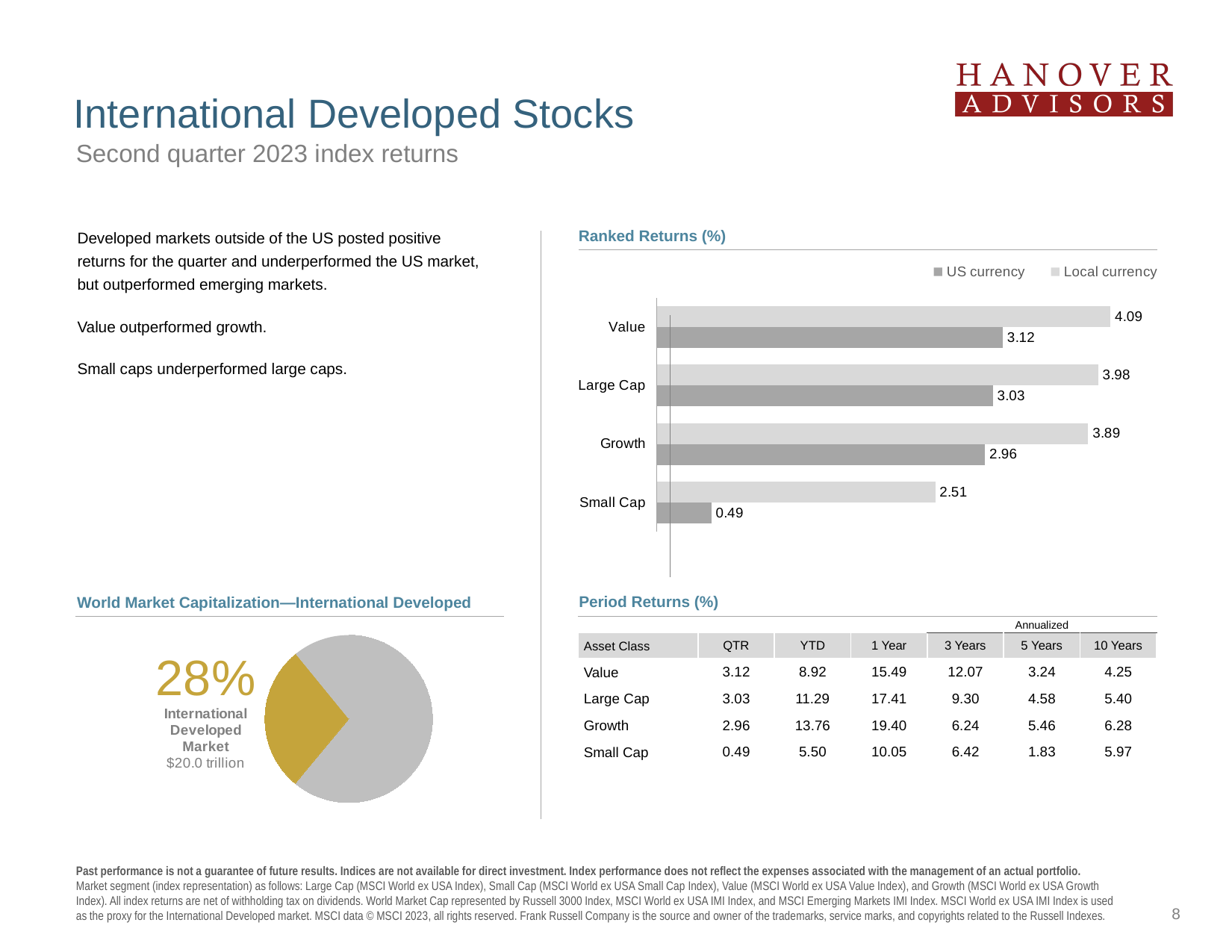
In the Ranked Returns (%) chart, which is larger for Large Cap: the US currency value or the Local currency value? Local currency In the Ranked Returns (%) chart, what is the difference between the Local currency and US currency values for Small Cap? 2.02 In the Ranked Returns (%) chart, which category has the highest Local currency value? Value In the Ranked Returns (%) chart, which category has the lowest US currency value? Small Cap How many series does the legend of the Ranked Returns (%) chart list? 2 How many categories are shown in the Ranked Returns (%) chart? 4 In the World Market Capitalization—International Developed pie chart, what dollar amount is shown for the International Developed Market? $20.0 trillion In the Ranked Returns (%) chart, what is the Local currency value for Small Cap? 2.51 What kind of chart is the Ranked Returns (%) chart? Bar chart In the Ranked Returns (%) chart, what is the Local currency value for Growth? 3.89 In the Ranked Returns (%) chart, what is the US currency value for Value? 3.12 In the World Market Capitalization—International Developed pie chart, what share does the International Developed Market represent? 28%